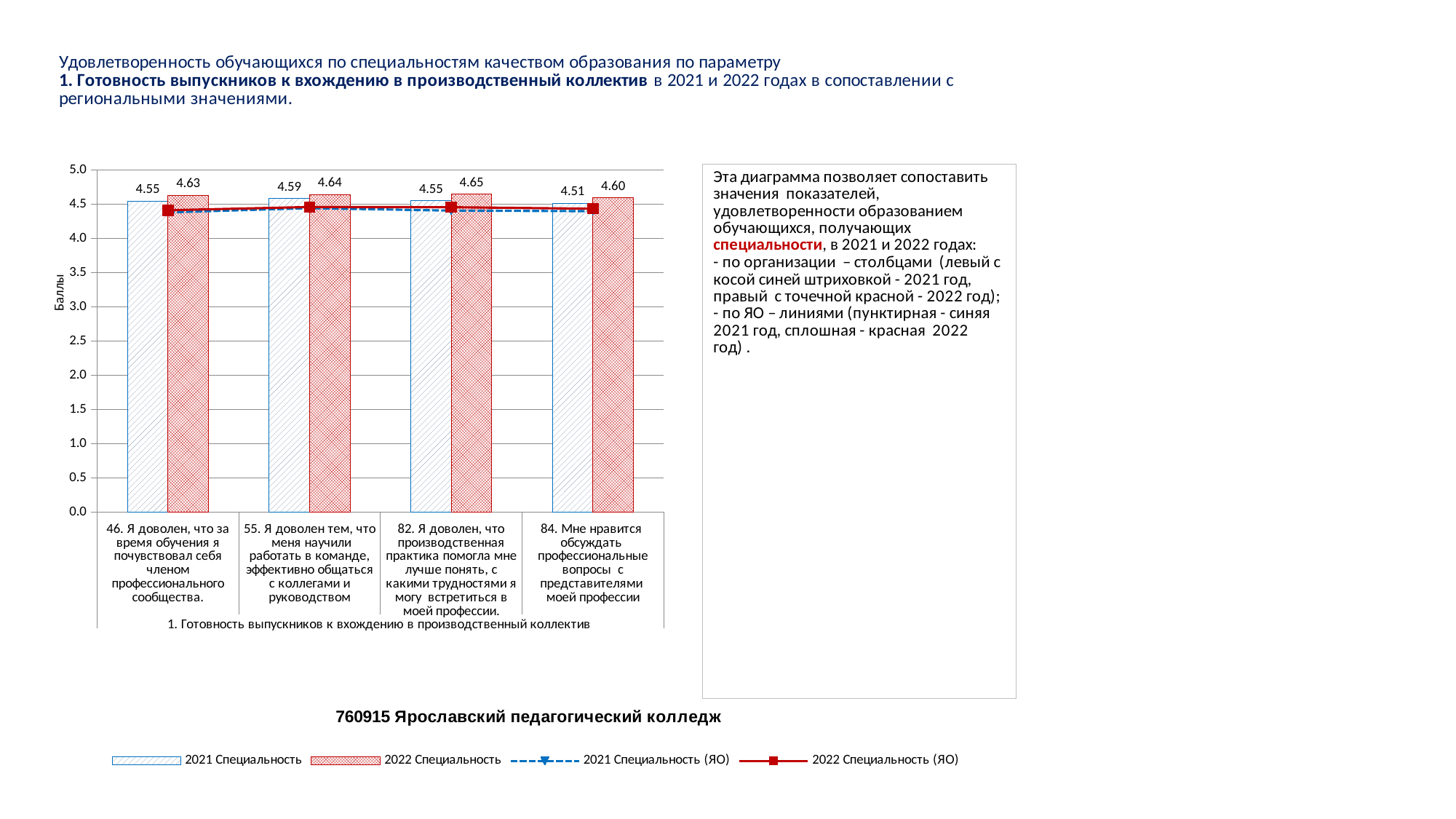
What is the value of the 2022 Специальность bar for category 84 (Мне нравится обсуждать профессиональные вопросы с представителями моей профессии)? 4.60 What is the label of the vertical axis of the chart? Баллы Which category has the highest 2022 Специальность bar? 82. Я доволен, что производственная практика помогла мне лучше понять, с какими трудностями я могу встретиться в моей профессии. Which category has the lowest 2021 Специальность bar? 84. Мне нравится обсуждать профессиональные вопросы с представителями моей профессии Is the 2021 Специальность (ЯО) line value for category 46 greater or less than 4.0? greater How many categories are shown on the x axis of the chart? 4 For category 84, which is larger: the 2021 Специальность bar or the 2022 Специальность bar? 2022 Специальность What is the value of the 2022 Специальность bar for category 46 (Я доволен, что за время обучения я почувствовал себя членом профессионального сообщества)? 4.63 What is the difference between the 2022 and 2021 Специальность values for category 82? 0.10 How many series does the chart legend list? 4 What kind of chart is shown on the slide? Combined bar and line chart What is the value of the 2021 Специальность bar for category 55 (Я доволен тем, что меня научили работать в команде)? 4.59